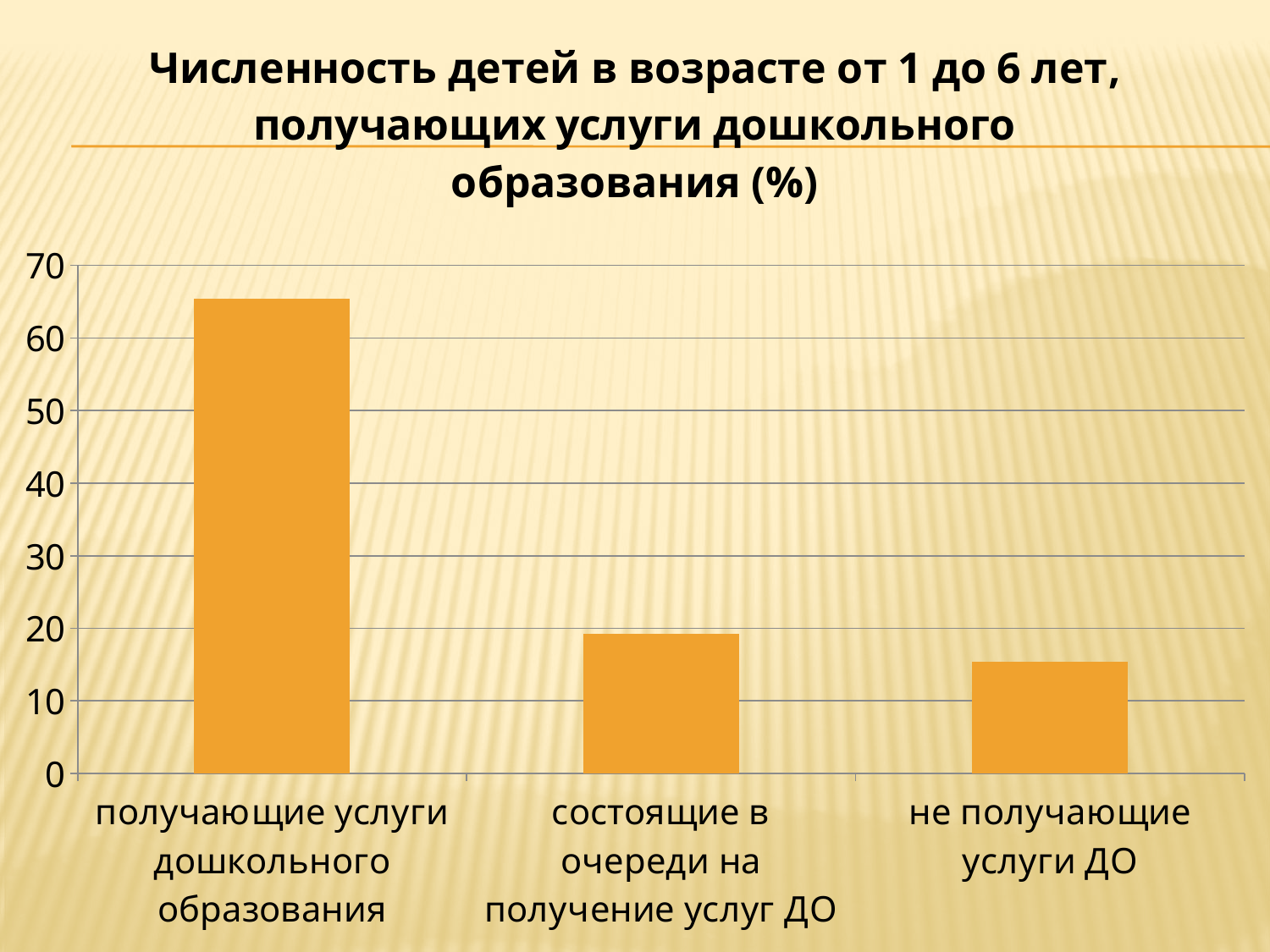
Which category has the highest value? получающие услуги дошкольного образования Do the values rise or fall from left to right across the categories? fall Is the value for 'не получающие услуги ДО' greater or less than 10? greater What kind of chart is shown on the slide? bar chart Is the value for 'не получающие услуги ДО' greater or less than 20? less Is the value for 'получающие услуги дошкольного образования' greater or less than 60? greater What is the maximum value shown on the vertical axis? 70 Which category has the lowest value? не получающие услуги ДО What colour are the bars in the chart? orange How many categories are shown on the chart? 3 Which is larger: the value for 'состоящие в очереди на получение услуг ДО' or the value for 'не получающие услуги ДО'? состоящие в очереди на получение услуг ДО